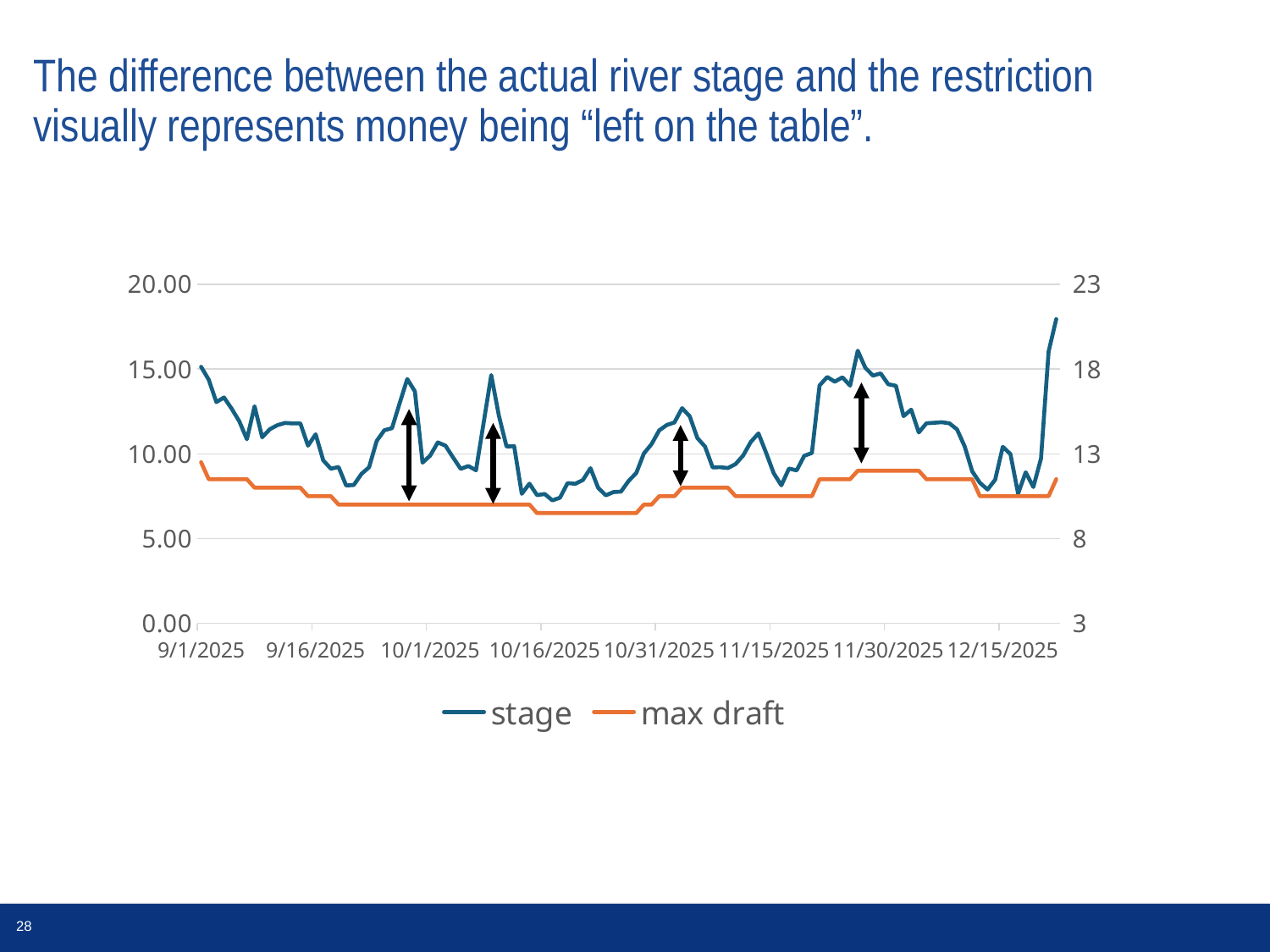
What is the highest tick value shown on the right-hand vertical axis? 23 What colour is the max draft line? orange Does the stage line rise or fall between 9/1/2025 and 9/16/2025? fall Which series is plotted higher on the chart at 10/1/2025, stage or max draft? stage What are the two series named in the legend? stage and max draft On the left axis, is the stage value at 9/1/2025 greater or less than 10.00? greater How many series does the legend list? 2 On the left axis, is the max draft value at 10/16/2025 greater or less than 10.00? less How many date labels are shown along the x axis? 8 What type of chart is shown on the slide? line chart On the left axis, is the stage value at the last plotted date (after 12/15/2025) greater or less than 15.00? greater Which series is plotted higher on the chart at 11/30/2025, stage or max draft? stage